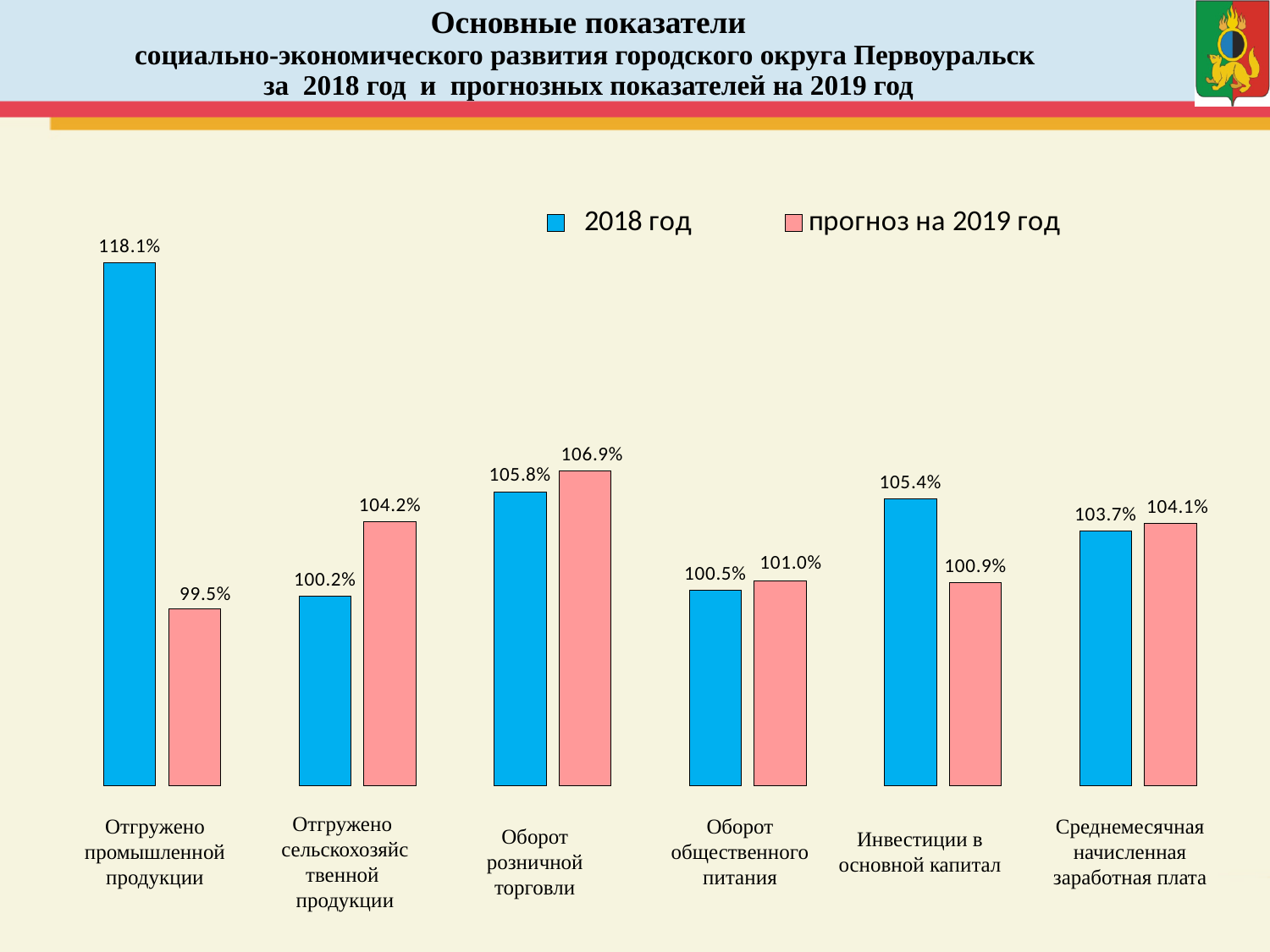
What is the прогноз на 2019 год value for Среднемесячная начисленная заработная плата? 104.1% How many series does the legend list? 2 What is the прогноз на 2019 год value for Оборот розничной торговли? 106.9% How many categories are shown on the chart? 6 What is the 2018 год value for Инвестиции в основной капитал? 105.4% What is the 2018 год value for Отгружено промышленной продукции? 118.1% For Инвестиции в основной капитал, which is larger: the 2018 год value or the прогноз на 2019 год value? 2018 год What is the difference between the 2018 год and прогноз на 2019 год values for Отгружено сельскохозяйственной продукции? 4.0% Which colour represents the прогноз на 2019 год series? Pink Which category has the lowest прогноз на 2019 год value? Отгружено промышленной продукции Which category has the highest 2018 год value? Отгружено промышленной продукции What type of chart is shown on the slide? Bar chart